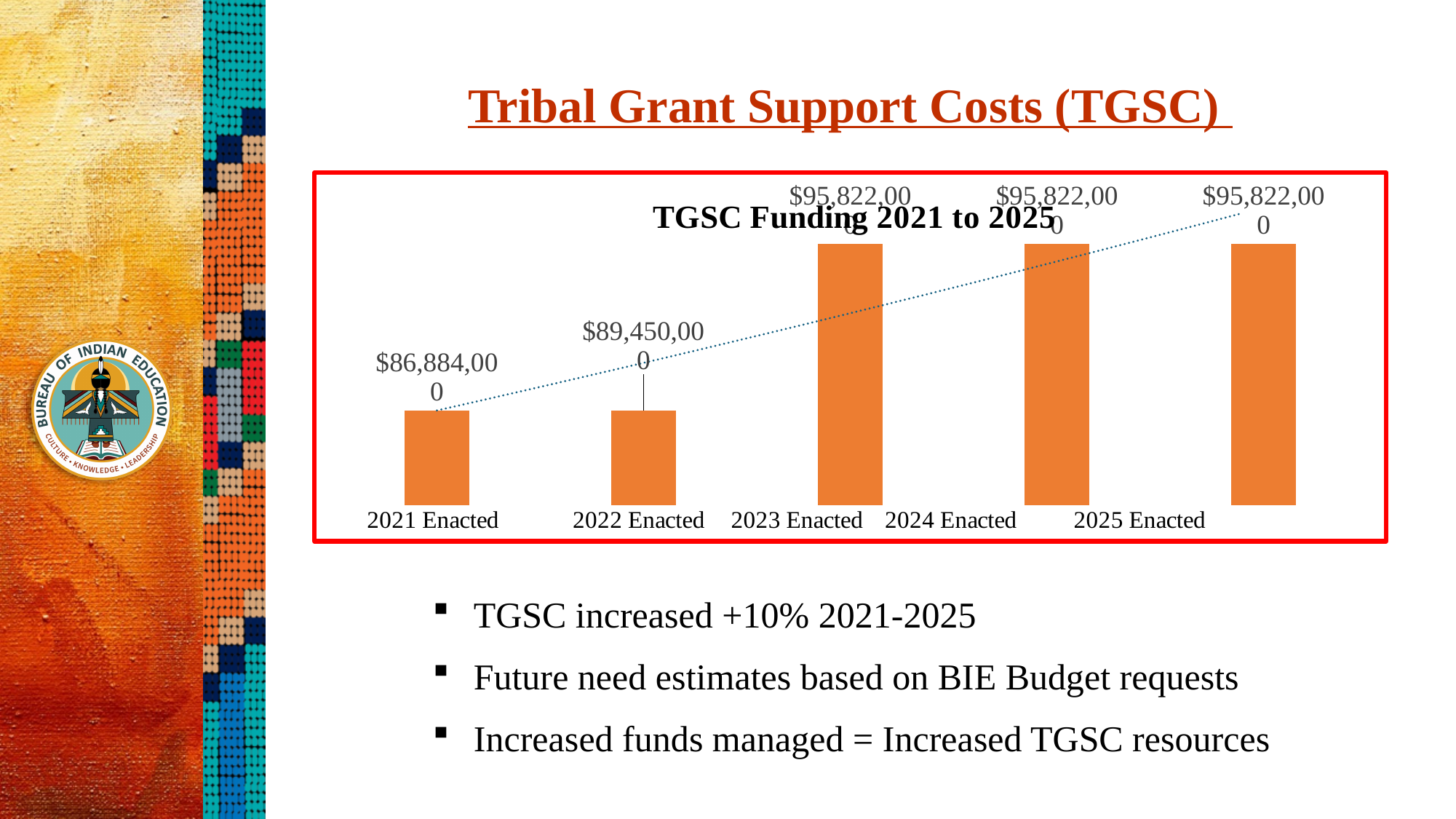
What is the title of the chart on the slide? TGSC Funding 2021 to 2025 What is the difference between the 2022 Enacted and 2021 Enacted values in the TGSC Funding 2021 to 2025 chart? $2,566,000 What kind of chart is the TGSC Funding 2021 to 2025 chart? Bar chart Which category has the lowest value in the TGSC Funding 2021 to 2025 chart? 2021 Enacted Which is larger in the TGSC Funding 2021 to 2025 chart, the value for 2022 Enacted or 2024 Enacted? 2024 Enacted What is the value for 2023 Enacted in the TGSC Funding 2021 to 2025 chart? $95,822,000 What is the value for 2021 Enacted in the TGSC Funding 2021 to 2025 chart? $86,884,000 How many categories are shown in the TGSC Funding 2021 to 2025 chart? 5 Do the values in the TGSC Funding 2021 to 2025 chart generally rise or fall from 2021 Enacted to 2025 Enacted? Rise What is the value for 2022 Enacted in the TGSC Funding 2021 to 2025 chart? $89,450,000 What is the difference between the 2023 Enacted and 2022 Enacted values in the TGSC Funding 2021 to 2025 chart? $6,372,000 What is the value for 2025 Enacted in the TGSC Funding 2021 to 2025 chart? $95,822,000